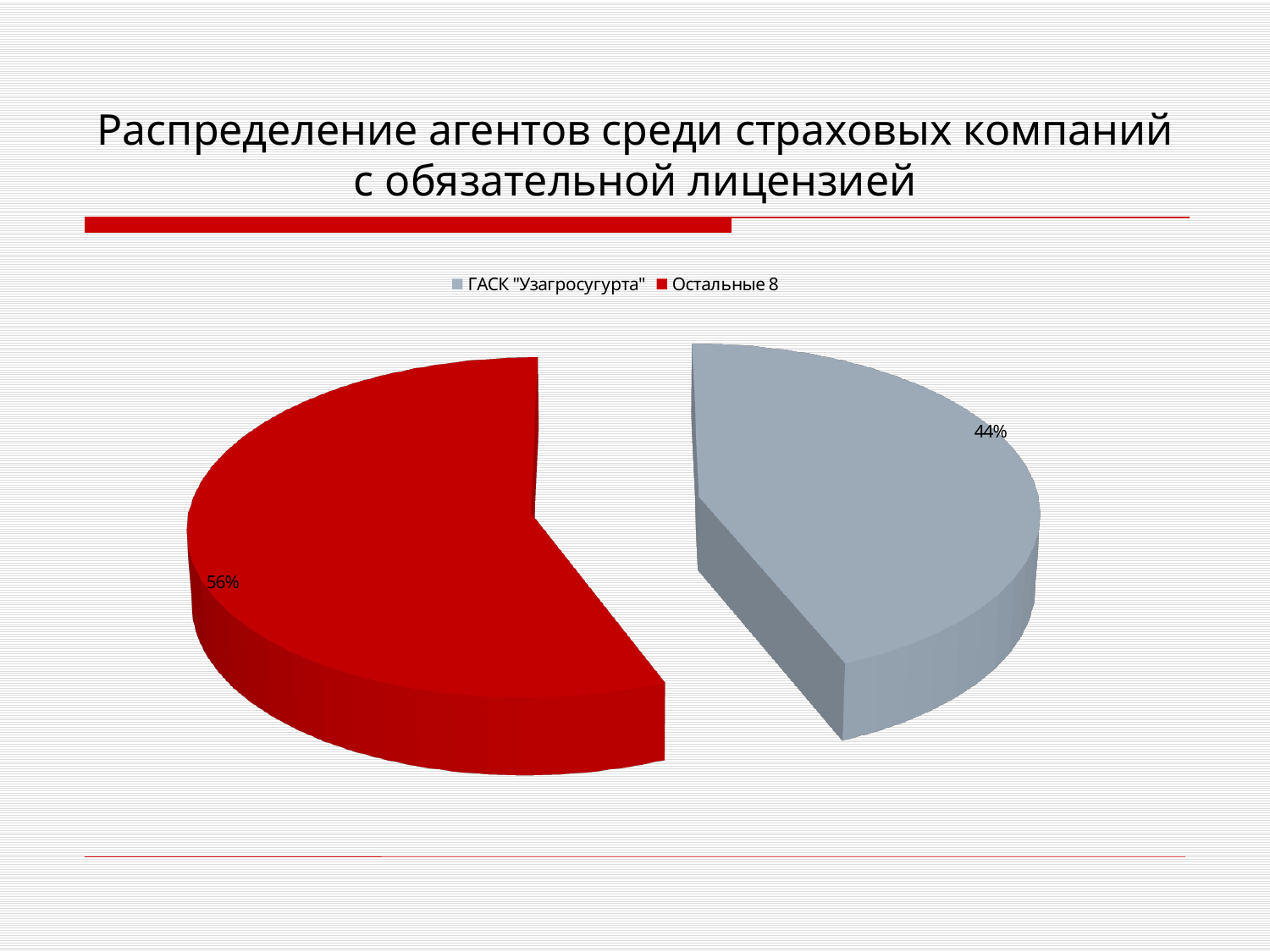
What colour is the slice for Остальные 8? red Which slice is the largest? Остальные 8 How many entries does the legend list? 2 How many slices does the pie chart have? 2 What share of the pie does ГАСК "Узагросугурта" hold? 44% What share of the pie does Остальные 8 hold? 56% What is the title of the slide? Распределение агентов среди страховых компаний с обязательной лицензией What kind of chart is shown on the slide? pie chart Which slice is the smallest? ГАСК "Узагросугурта" What is the difference in percentage points between the Остальные 8 slice and the ГАСК "Узагросугурта" slice? 12 Which is larger, the share for ГАСК "Узагросугурта" or the share for Остальные 8? Остальные 8